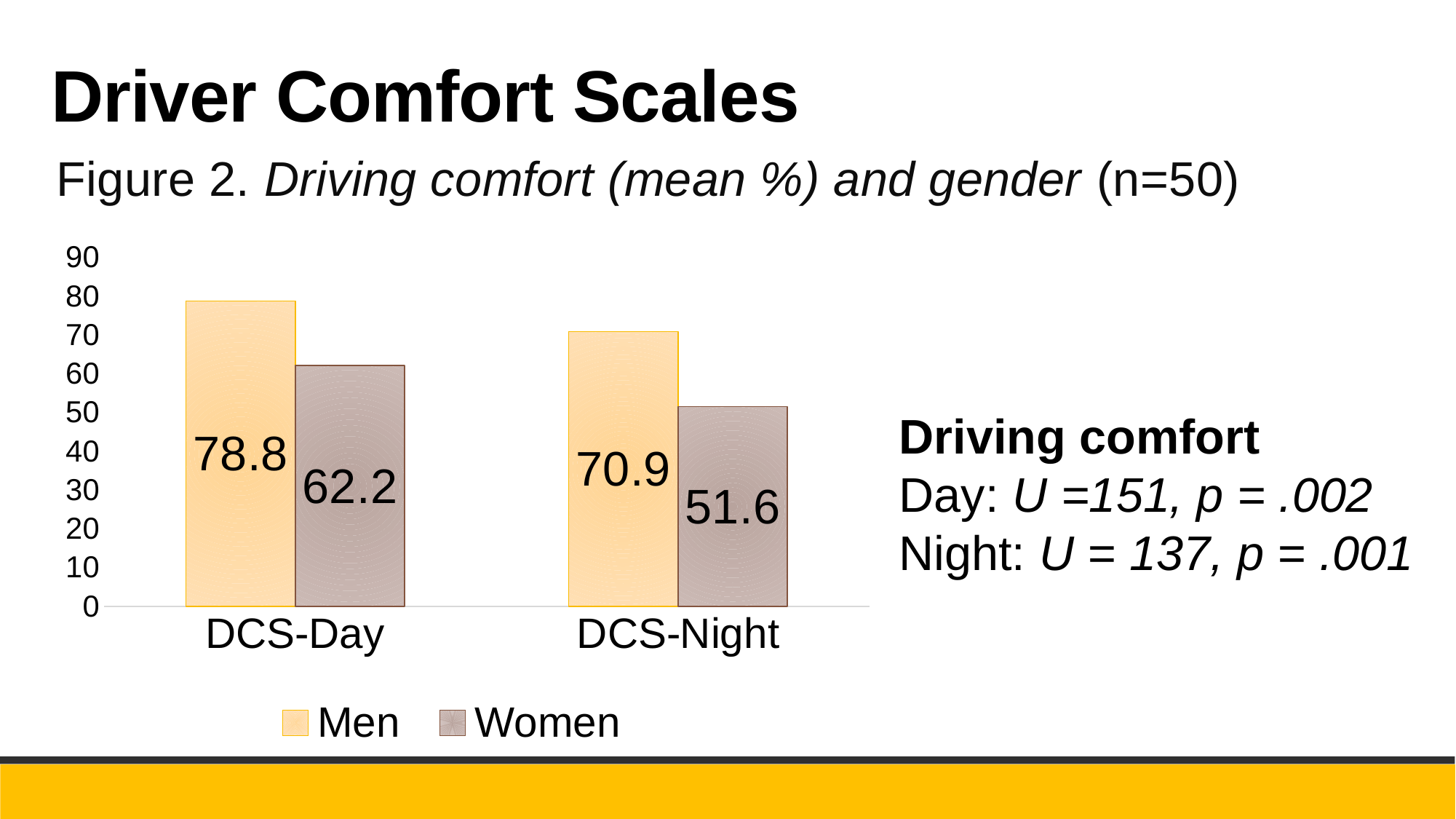
What kind of chart is shown on the slide? Bar chart What is the difference between the Men and Women values for DCS-Night? 19.3 Which bar has the lowest value on the chart? Women, DCS-Night How many series does the legend list? 2 What is the value for Women in the DCS-Night category? 51.6 Which bar has the highest value on the chart? Men, DCS-Day What is the value for Women in the DCS-Day category? 62.2 What is the difference between the Men and Women values for DCS-Day? 16.6 How many categories are shown on the x axis? 2 What is the value for Men in the DCS-Night category? 70.9 What is the value for Men in the DCS-Day category? 78.8 Which is larger, the Men value for DCS-Night or the Women value for DCS-Day? Men value for DCS-Night